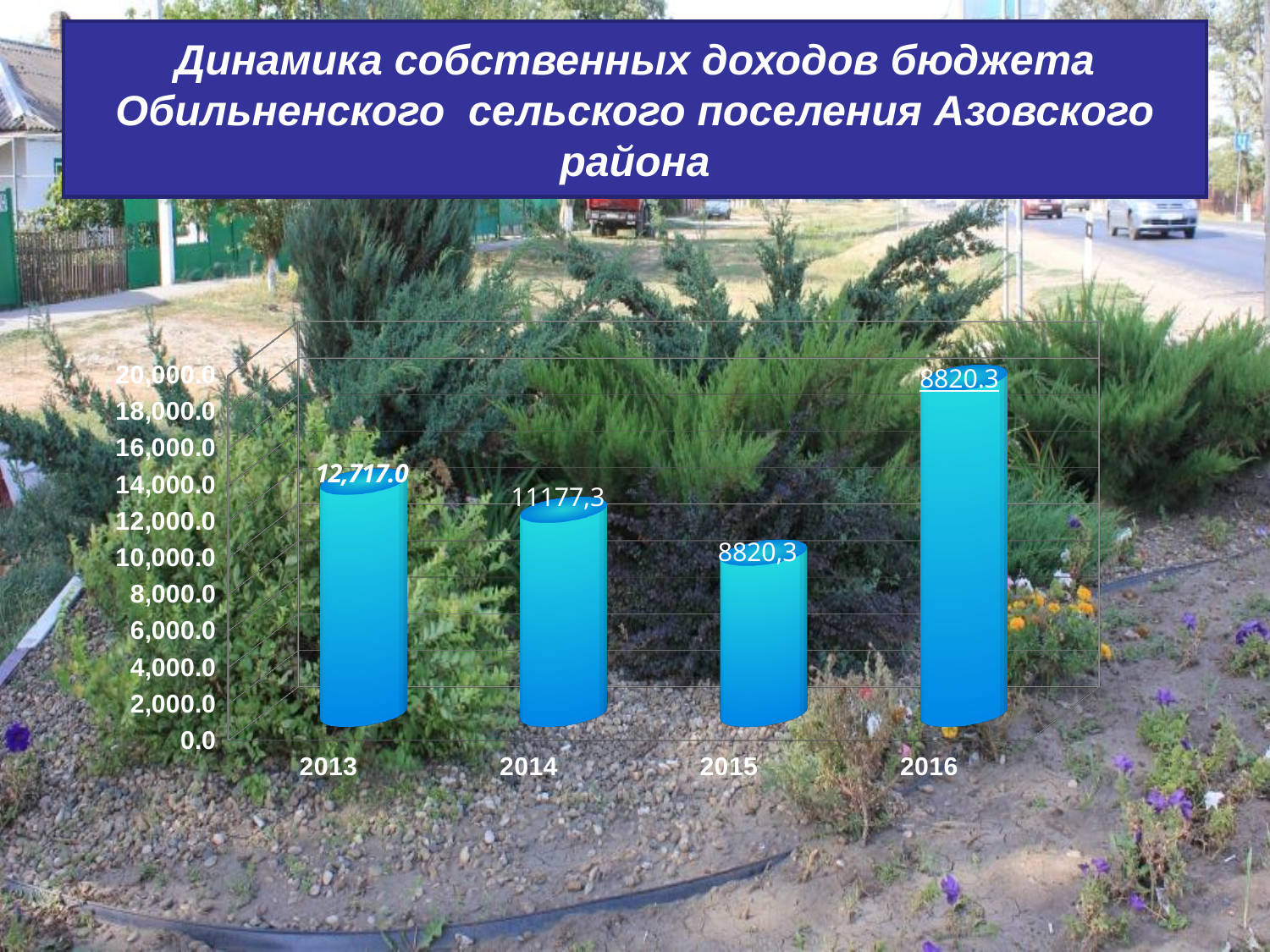
What is the value shown for 2014? 11177,3 Which year has the shortest bar? 2015 What is the difference between the values for 2014 and 2015? 2357.0 Which year has the tallest bar? 2016 How many years are shown on the x axis? 4 Do the values rise or fall from 2013 to 2015? fall What is the value shown for 2015? 8820,3 What kind of chart is shown on the slide? bar chart What is the difference between the values for 2013 and 2014? 1539.7 Is the bar for 2016 greater or less than 16,000.0? greater Which is larger, the value for 2013 or the value for 2014? 2013 What is the value shown for 2013? 12,717.0